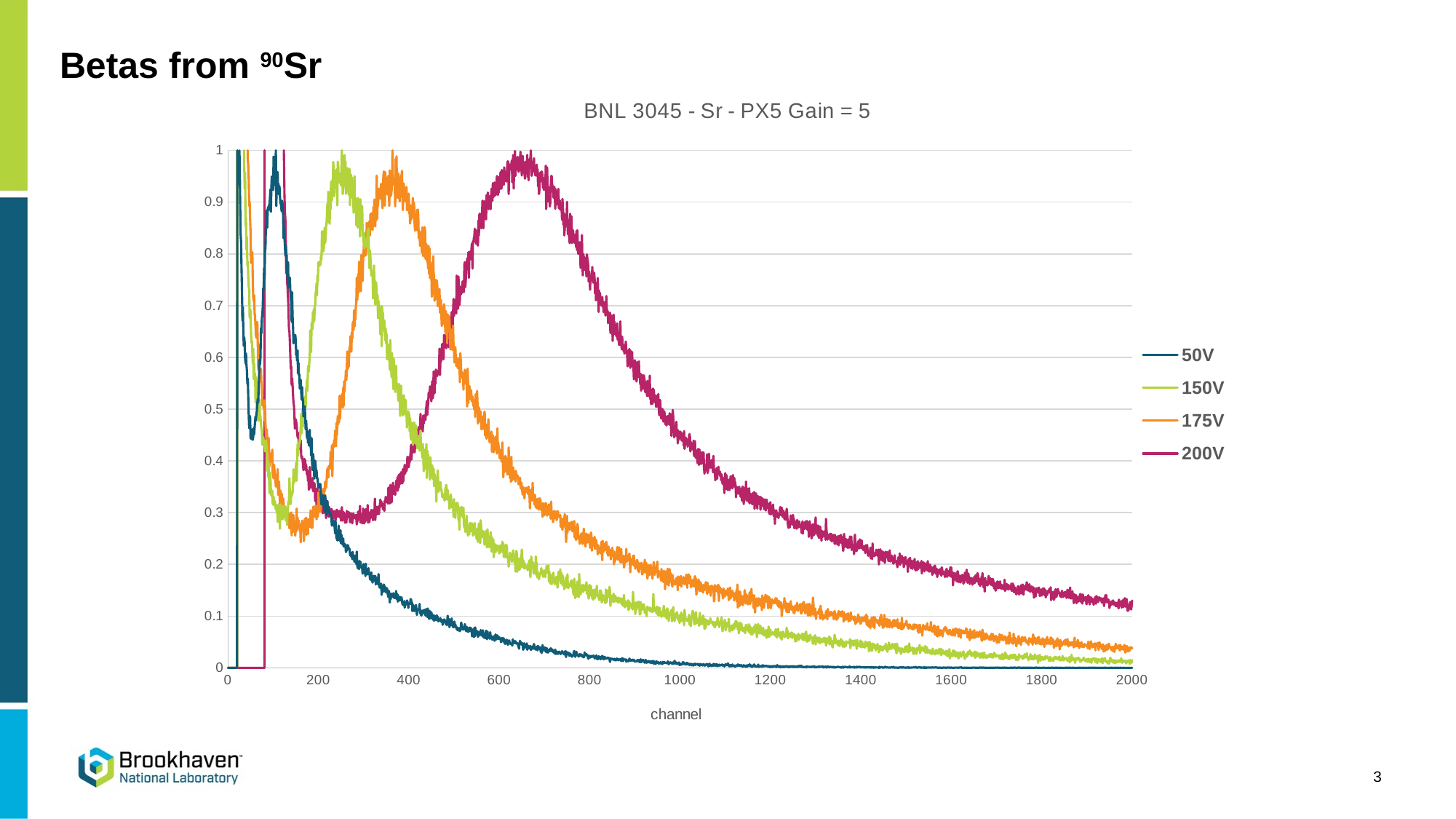
Which series has its main peak at the highest channel number? 200V What is the label of the x axis? channel Does the 200V series rise or fall between channel 800 and channel 2000? fall What kind of chart is shown on the slide? line chart At channel 1600, which series has the higher value, 200V or 50V? 200V Is the value of the 200V series at channel 2000 greater or less than 0.1? greater How many series does the legend list? 4 Is the value of the 50V series at channel 1000 greater or less than 0.1? less Is the value of the 200V series at channel 1000 greater or less than 0.4? greater What is the title of the chart? BNL 3045 - Sr - PX5 Gain = 5 Which series has its main peak at the lowest channel number? 50V